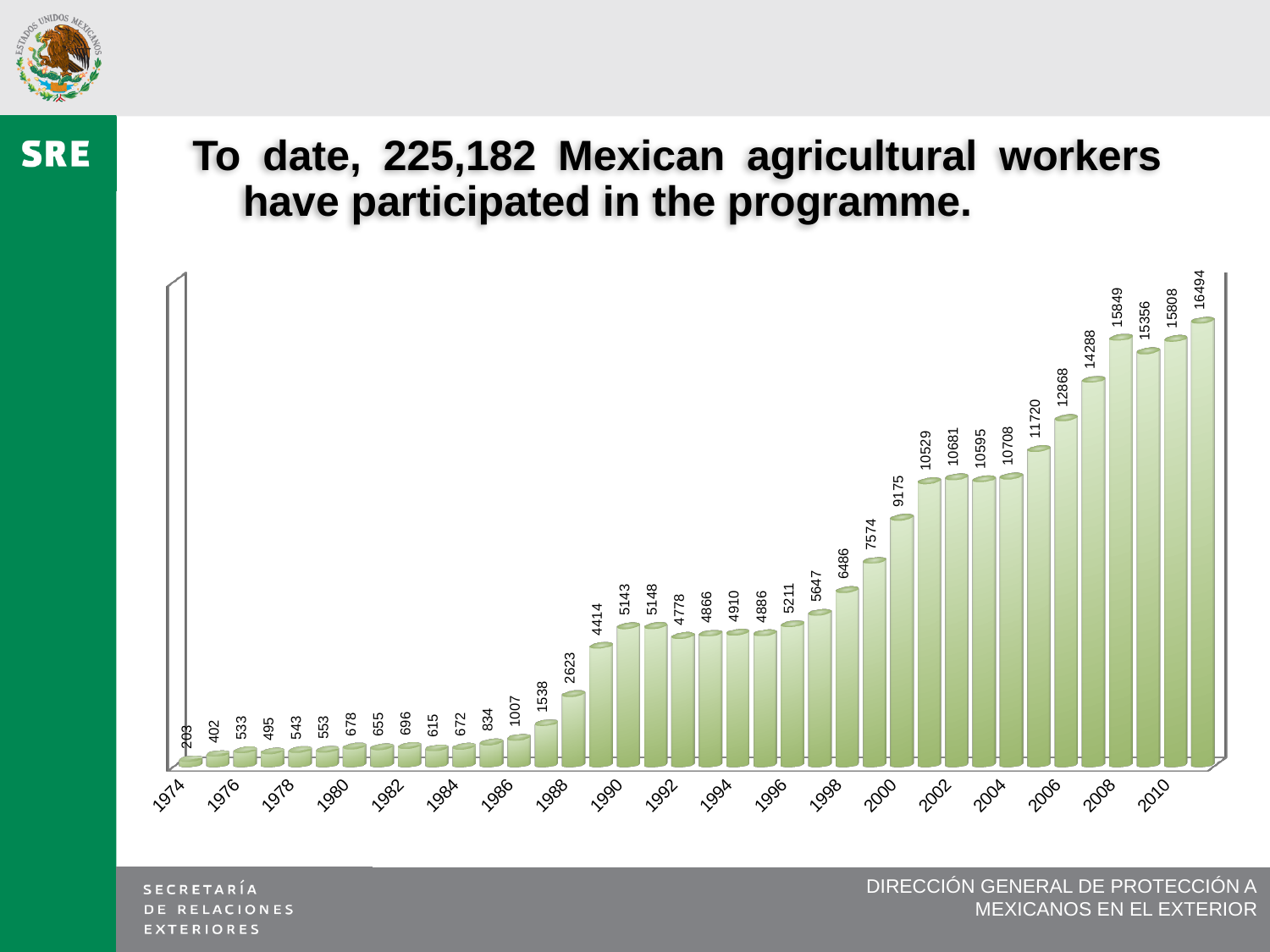
What value is shown for 2010? 15808 What kind of chart is shown on the slide? Bar chart What is the highest value labelled on the chart? 16494 What value is shown for 2000? 9175 Which year has the larger value, 1988 or 1990? 1990 Do the values generally rise or fall from 1974 to the last bar? Rise How many bars are plotted on the chart? 38 What value is shown for 1974? 203 What value is shown for 1990? 5143 According to the slide title, how many Mexican agricultural workers have participated in the programme to date? 225,182 Which year has the lowest value? 1974 What is the difference between the values for 2010 and 2000? 6633